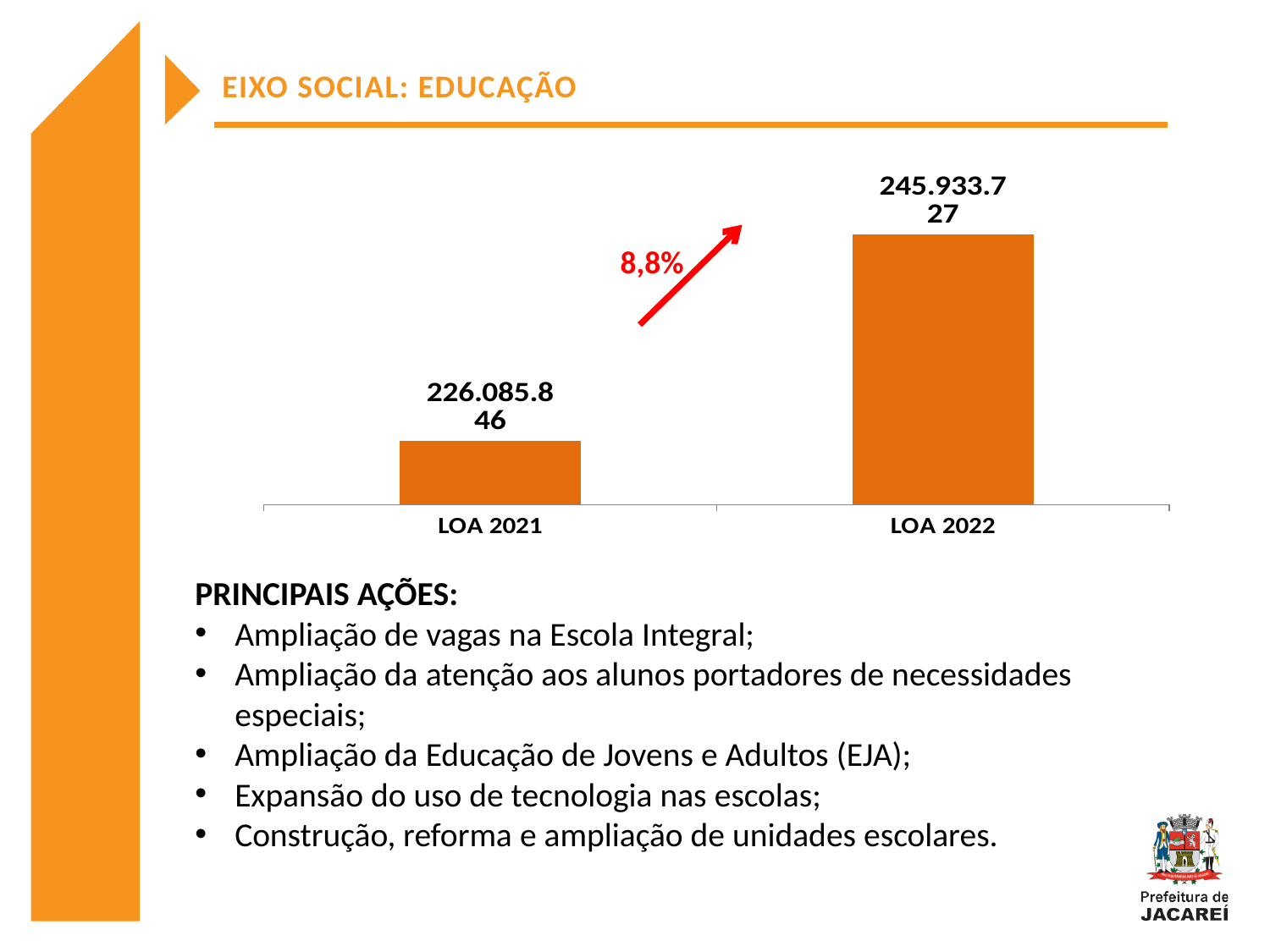
What is the difference between the LOA 2022 and LOA 2021 values? 19.847.881 How many bars are plotted in the chart? 2 What colour are the bars in the chart? Orange What percentage change is annotated next to the red arrow on the chart? 8,8% Which is larger, the value for LOA 2021 or for LOA 2022? LOA 2022 Which category has the highest value? LOA 2022 Which category has the lowest value? LOA 2021 Do the values rise or fall from LOA 2021 to LOA 2022? Rise What is the value shown for LOA 2022? 245.933.727 What kind of chart is shown on the slide? Bar chart What is the value shown for LOA 2021? 226.085.846